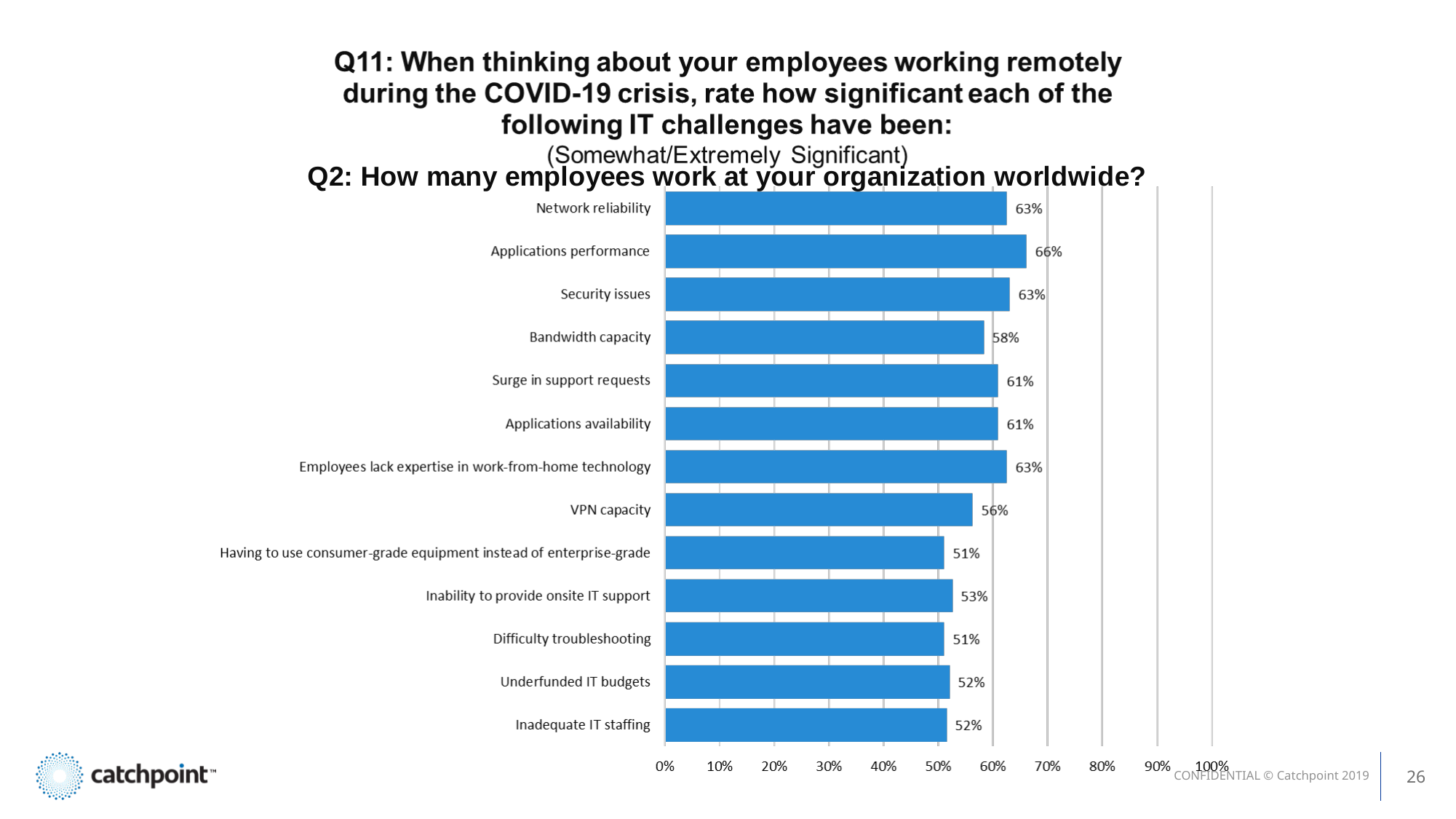
What percentage is shown for Applications performance? 66% Which has a higher value, Bandwidth capacity or VPN capacity? Bandwidth capacity What is the difference between the values for Applications performance and Difficulty troubleshooting? 15 percentage points Which IT challenge has the highest percentage? Applications performance What is the value for VPN capacity? 56% How many IT challenges are listed on the chart? 13 What is the lowest percentage shown on the chart? 51% What is the difference between the values for Security issues and Underfunded IT budgets? 11 percentage points What is the value for Bandwidth capacity? 58% What kind of chart is shown on the slide? Bar chart What percentage is shown for Inability to provide onsite IT support? 53% Is the value for Network reliability greater or less than 60%? greater